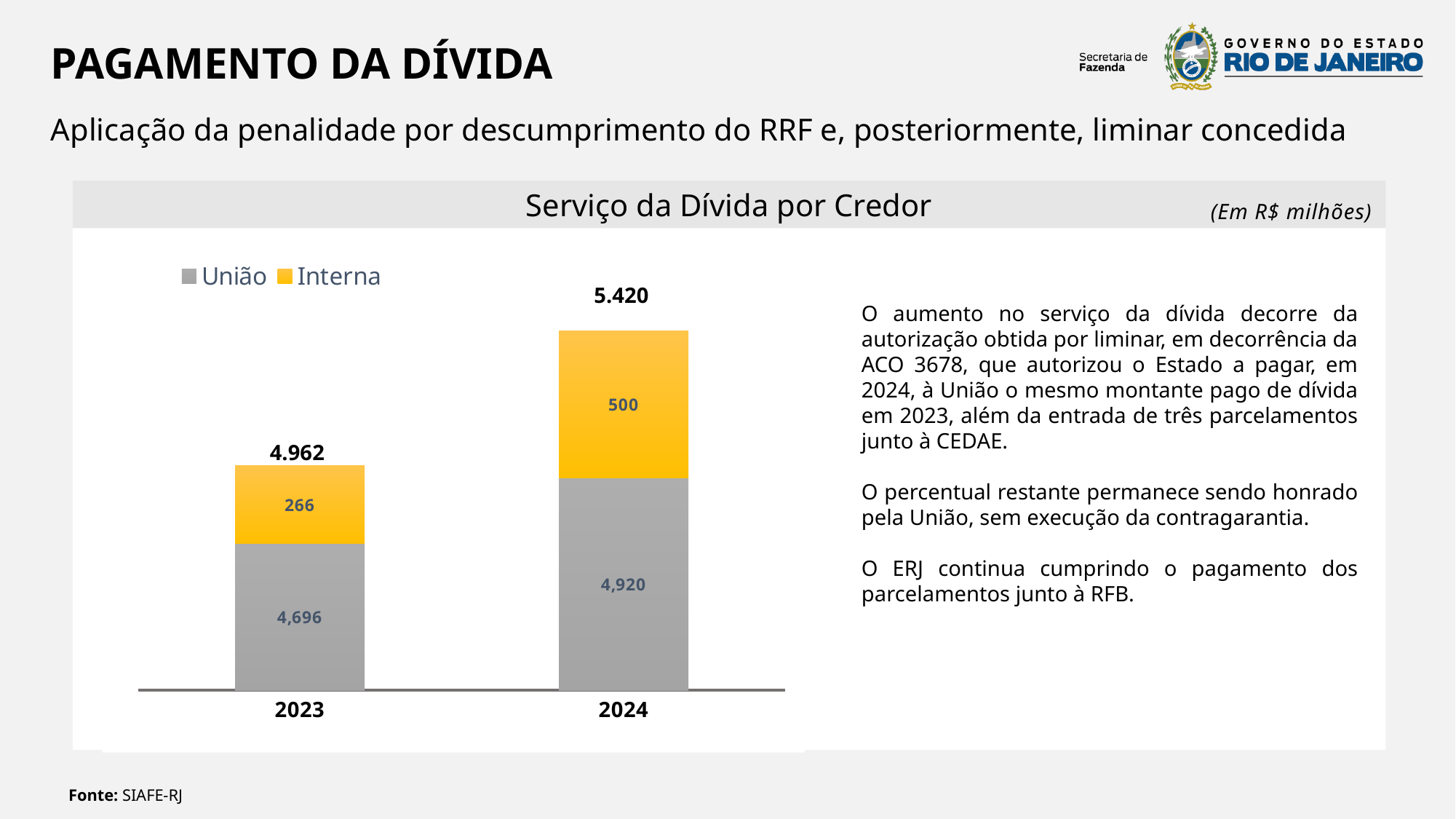
What is the value for Interna in 2024? 500 How many series does the legend list? 2 What is the total of the stacked bar for 2024? 5.420 What is the total of the stacked bar for 2023? 4.962 Which colour represents the Interna series? Yellow Is the Interna value larger in 2023 or in 2024? 2024 Which year has the higher total debt service? 2024 What is the value for União in 2023? 4,696 What is the value for União in 2024? 4,920 What is the value for Interna in 2023? 266 What is the difference between the Interna values for 2024 and 2023? 234 What kind of chart is shown on the slide? Stacked bar chart